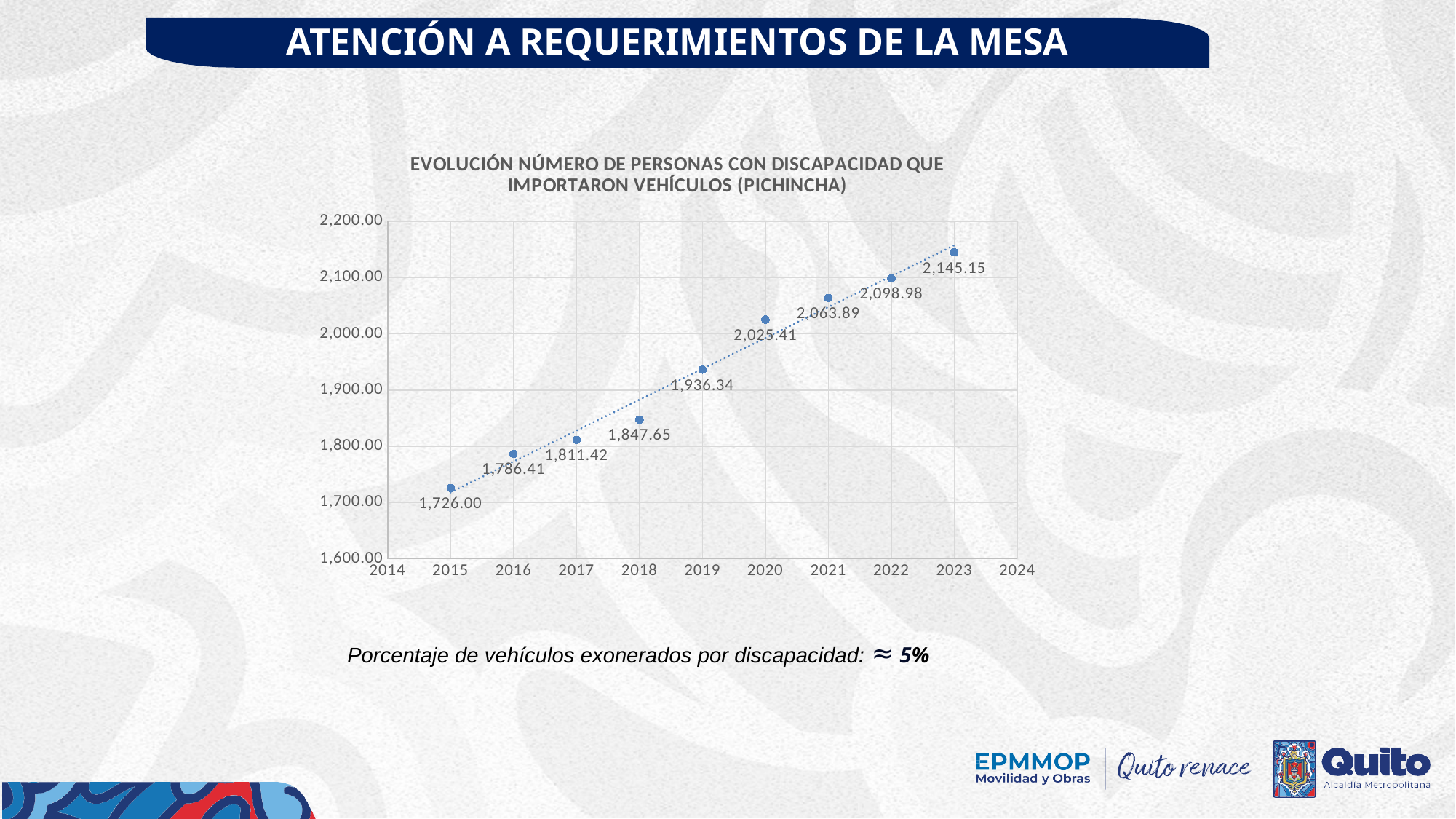
What is the value for 2019? 1,936.34 What is the value for 2021? 2,063.89 What is the difference between the values for 2020 and 2019? 89.07 Which is larger, the value for 2018 or the value for 2017? 2018 What is the value for 2015? 1,726.00 Do the values rise or fall from 2015 to 2023? Rise What is the difference between the values for 2023 and 2015? 419.15 How many data points are plotted in the chart? 9 Which year has the highest value? 2023 Which year has the lowest value? 2015 What kind of chart is shown on the slide? Scatter chart What is the value for 2023? 2,145.15